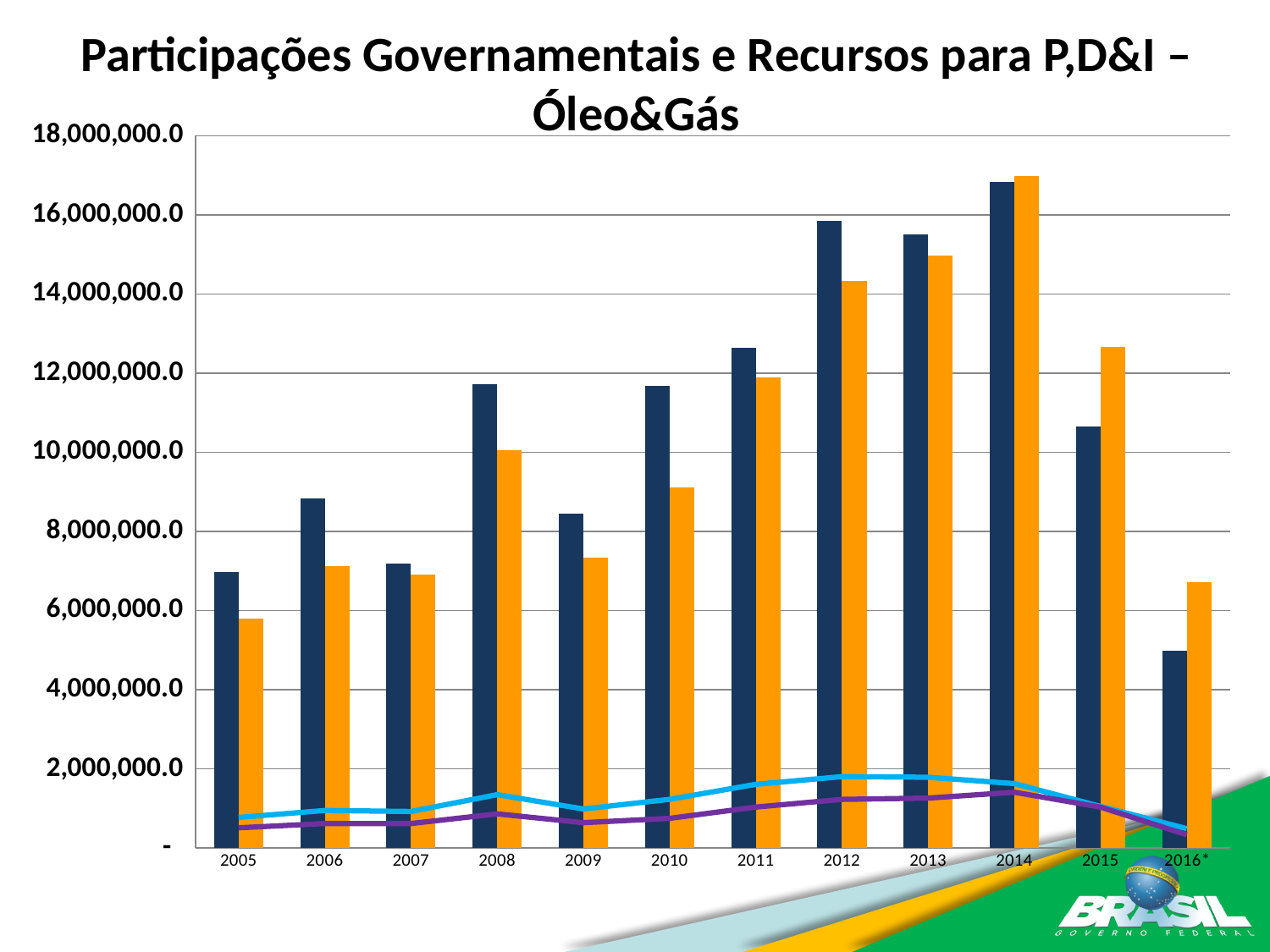
In which year is the orange bar the highest? 2014 What is the title of the chart? Participações Governamentais e Recursos para P,D&I – Óleo&Gás Is the value of the dark blue bar for 2012 greater or less than 14,000,000.0? greater In which year is the orange bar the lowest? 2005 How many years are shown on the x axis of the chart? 12 For 2015, which bar is taller, the dark blue bar or the orange bar? the orange bar Is the value of the dark blue bar for 2016* greater or less than 6,000,000.0? less What kind of chart is shown on the slide? combination bar and line chart Is the value of the orange bar for 2008 greater or less than 8,000,000.0? greater In which year is the dark blue bar the lowest? 2016* Do the dark blue bars rise or fall from 2014 to 2016*? fall In which year is the dark blue bar the highest? 2014